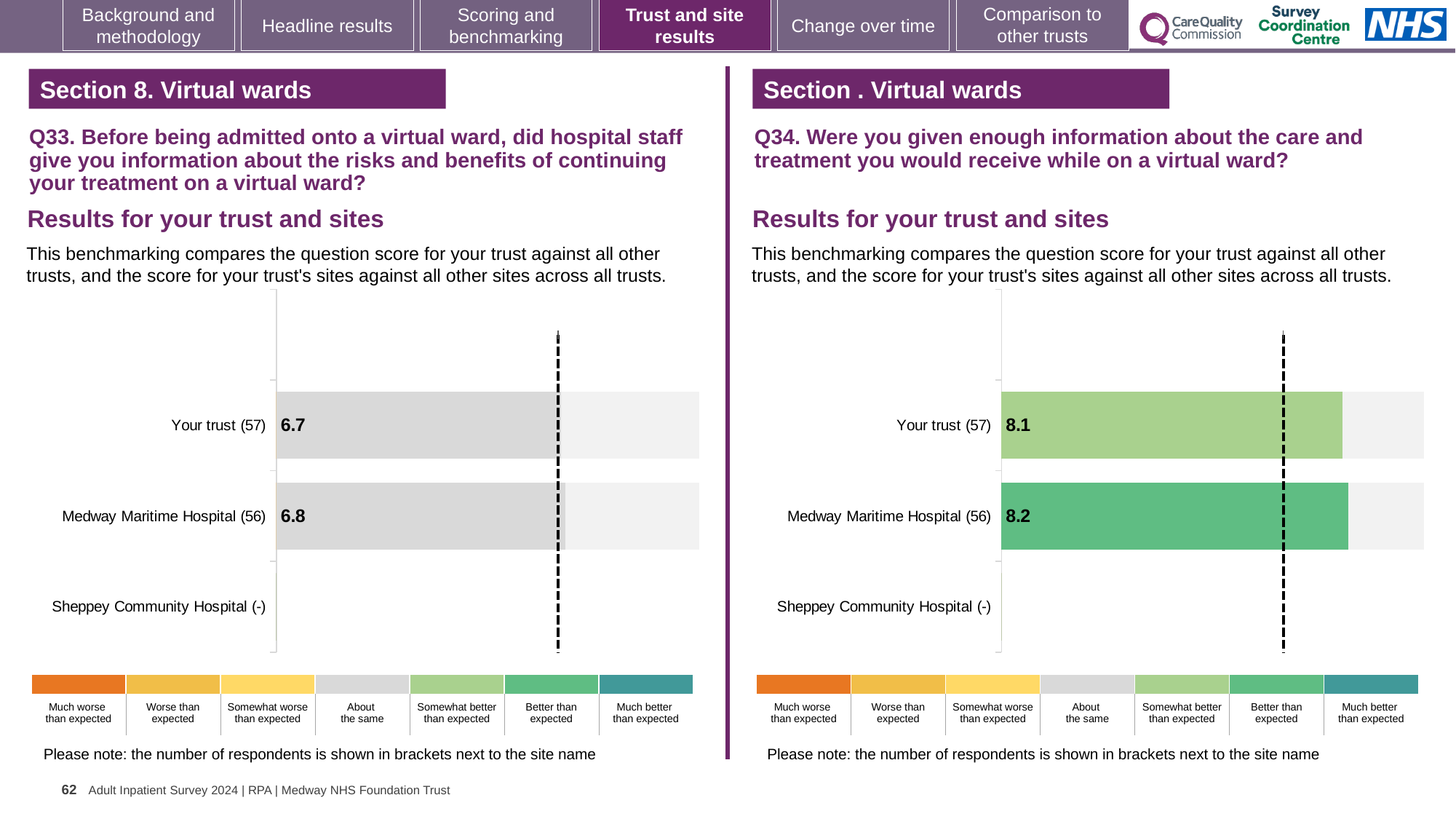
In the Q33 chart on the left, what is the difference between the Medway Maritime Hospital score and the Your trust score? 0.1 Which is larger: the Your trust score in the Q33 chart or the Your trust score in the Q34 chart? Q34 chart (8.1) In the Q33 chart on the left, which benchmark category does the colour of the Your trust bar correspond to? About the same In the Q34 chart on the right, what is the difference between the Medway Maritime Hospital score and the Your trust score? 0.1 How many site/trust categories are listed on the y axis of the Q33 chart on the left? 3 In the Q33 chart on the left, what is the score for Medway Maritime Hospital (56)? 6.8 In the Q34 chart on the right, what is the score for Your trust (57)? 8.1 In the Q34 chart on the right, what is the score for Medway Maritime Hospital (56)? 8.2 What type of chart is used for the Q34 results on the right? Bar chart In the Q34 chart on the right, which benchmark category does the colour of the Medway Maritime Hospital bar correspond to? Better than expected How many respondents are shown in brackets for Medway Maritime Hospital in the Q33 chart? 56 In the Q33 chart on the left, what is the score for Your trust (57)? 6.7